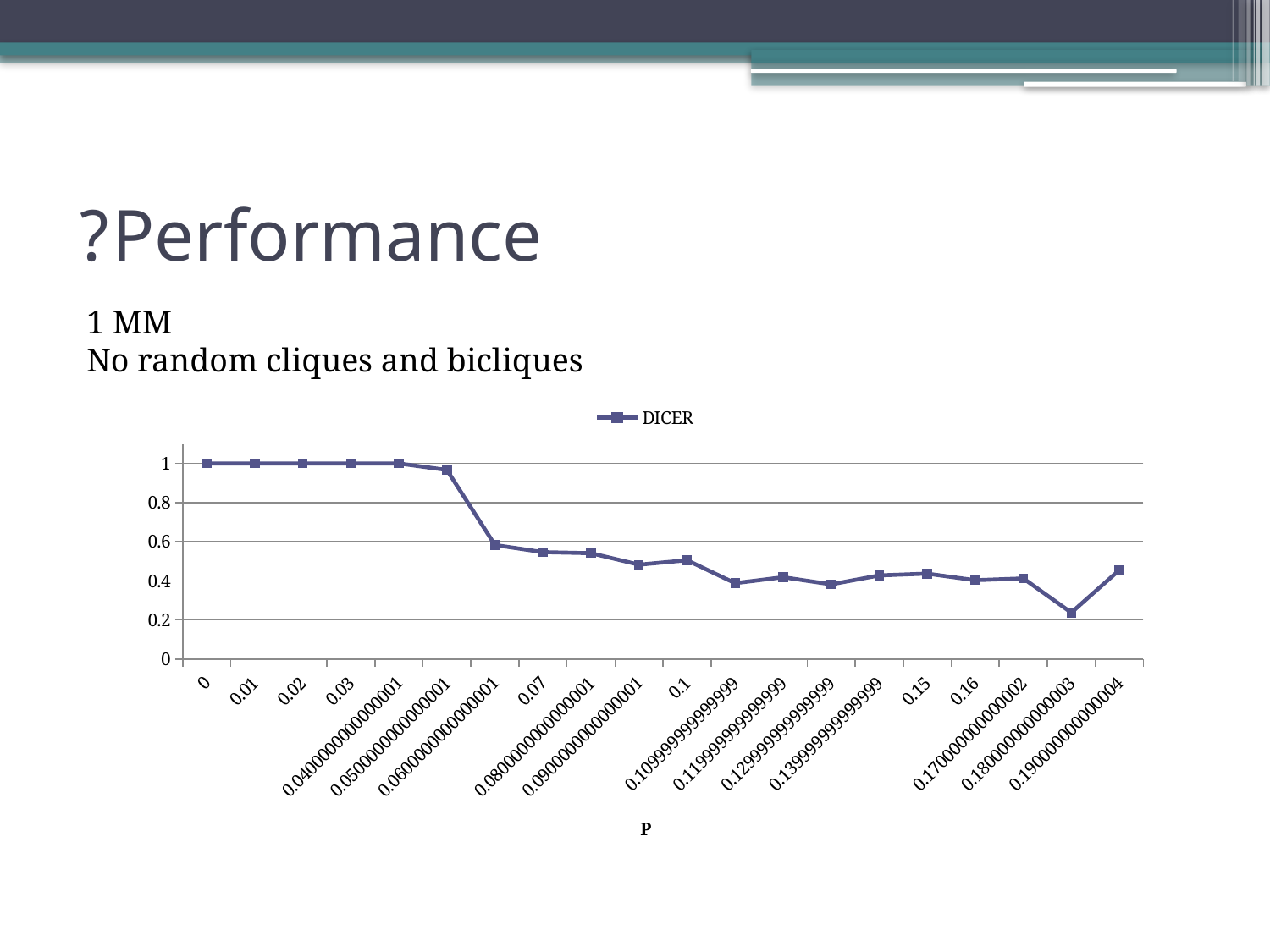
Overall, do the DICER values rise or fall as P increases along the x axis? fall How many series does the legend list? 1 What type of chart is shown on the slide? line chart What is the DICER value at P = 0? 1 How many data points are plotted along the x axis? 20 Is the DICER value at P = 0.07 greater or less than 0.8? less At which P value is the DICER value lowest? 0.180000000000003 Which has the larger DICER value, P = 0.03 or P = 0.07? 0.03 What is the DICER value at P = 0.03? 1 What is the title of the x axis? P Is the DICER value at P = 0.07 greater or less than 0.4? greater Is the DICER value at P = 0.180000000000003 greater or less than 0.4? less